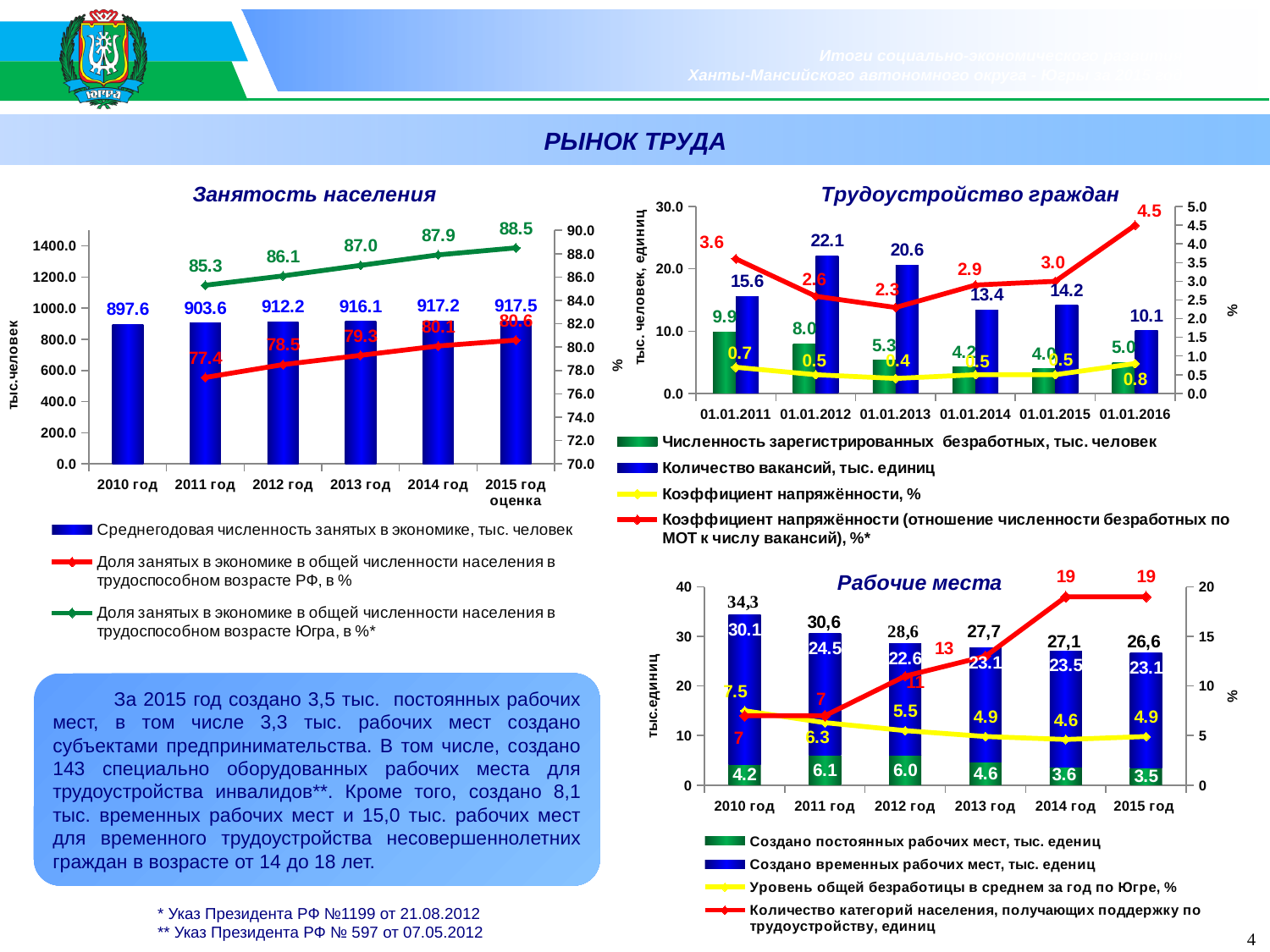
On the 'Рабочие места' chart, what is the total of the stacked bar for 2010 год? 34,3 On the 'Трудоустройство граждан' chart, what is the number of vacancies (тыс. единиц) on 01.01.2012? 22.1 On the 'Рабочие места' chart, which is larger: the number of temporary jobs created in 2011 год or in 2012 год? 2011 год On the 'Трудоустройство граждан' chart, what is the value of the red line (коэффициент напряжённости по МОТ) on 01.01.2016? 4.5 On the 'Занятость населения' chart, does the green line (share of employed in Югра) rise or fall from 2011 год to 2015 год оценка? rise On the 'Рабочие места' chart, what is the number of population categories receiving employment support (red line) in 2014 год? 19 On the 'Занятость населения' chart, how many series does the legend list? 3 On the 'Занятость населения' chart, what is the share of employed in the working-age population of Югра for 2015 год оценка? 88.5 On the 'Трудоустройство граждан' chart, on which date is the number of registered unemployed highest? 01.01.2011 On the 'Рабочие места' chart, which year has the lowest number of permanent jobs created (green segment)? 2015 год On the 'Занятость населения' chart, what is the average annual number of employed in the economy for 2012 год? 912.2 On the 'Трудоустройство граждан' chart, what is the difference between the number of vacancies on 01.01.2012 and on 01.01.2016? 12.0